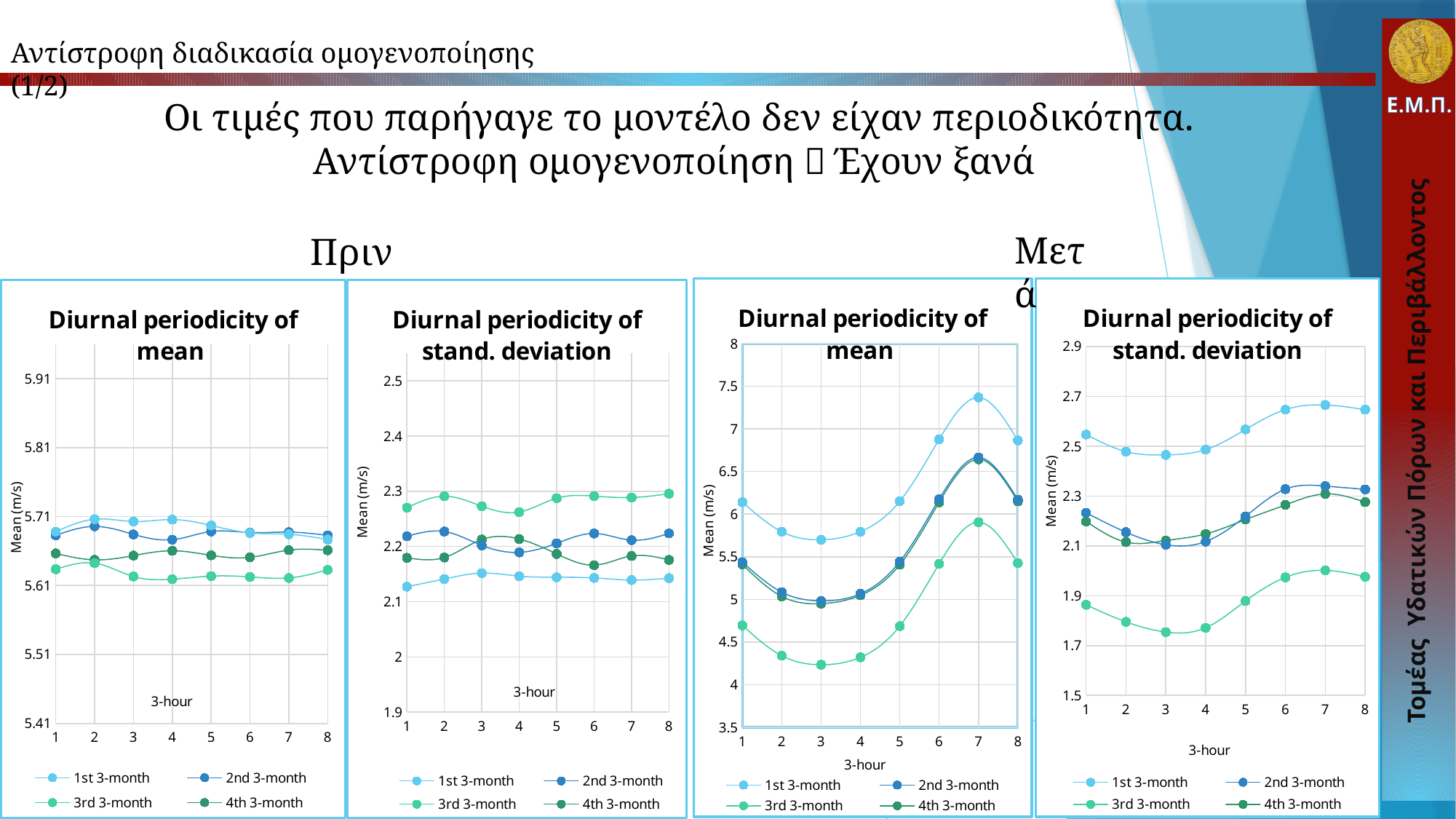
In the third chart from the left ('Diurnal periodicity of mean' under 'Μετά'), which series has the lowest values across all 3-hour points? 3rd 3-month In the rightmost chart ('Diurnal periodicity of stand. deviation' under 'Μετά'), is the value of the 1st 3-month series at 3-hour 7 greater or less than 2.5? greater In the third chart from the left ('Diurnal periodicity of mean' under 'Μετά'), does the 1st 3-month series rise or fall from 3-hour 3 to 3-hour 7? rise In the third chart from the left ('Diurnal periodicity of mean' under 'Μετά'), which series has the highest value at 3-hour 7? 1st 3-month In the third chart from the left ('Diurnal periodicity of mean' under 'Μετά'), is the value of the 3rd 3-month series at 3-hour 3 greater or less than 4.5? less In the second chart from the left ('Diurnal periodicity of stand. deviation' under 'Πριν'), which series has the highest values? 3rd 3-month What kind of chart is the third chart from the left, titled 'Diurnal periodicity of mean' under 'Μετά'? Line chart How many series does the legend of the rightmost chart ('Diurnal periodicity of stand. deviation' under 'Μετά') list? 4 In the third chart from the left ('Diurnal periodicity of mean' under 'Μετά'), is the value of the 1st 3-month series at 3-hour 7 greater or less than 7? greater How many 3-hour points are plotted along the x axis of the leftmost chart ('Diurnal periodicity of mean' under 'Πριν')? 8 In the third chart from the left ('Diurnal periodicity of mean' under 'Μετά'), at 3-hour 1, which is larger: the 1st 3-month series or the 3rd 3-month series? 1st 3-month